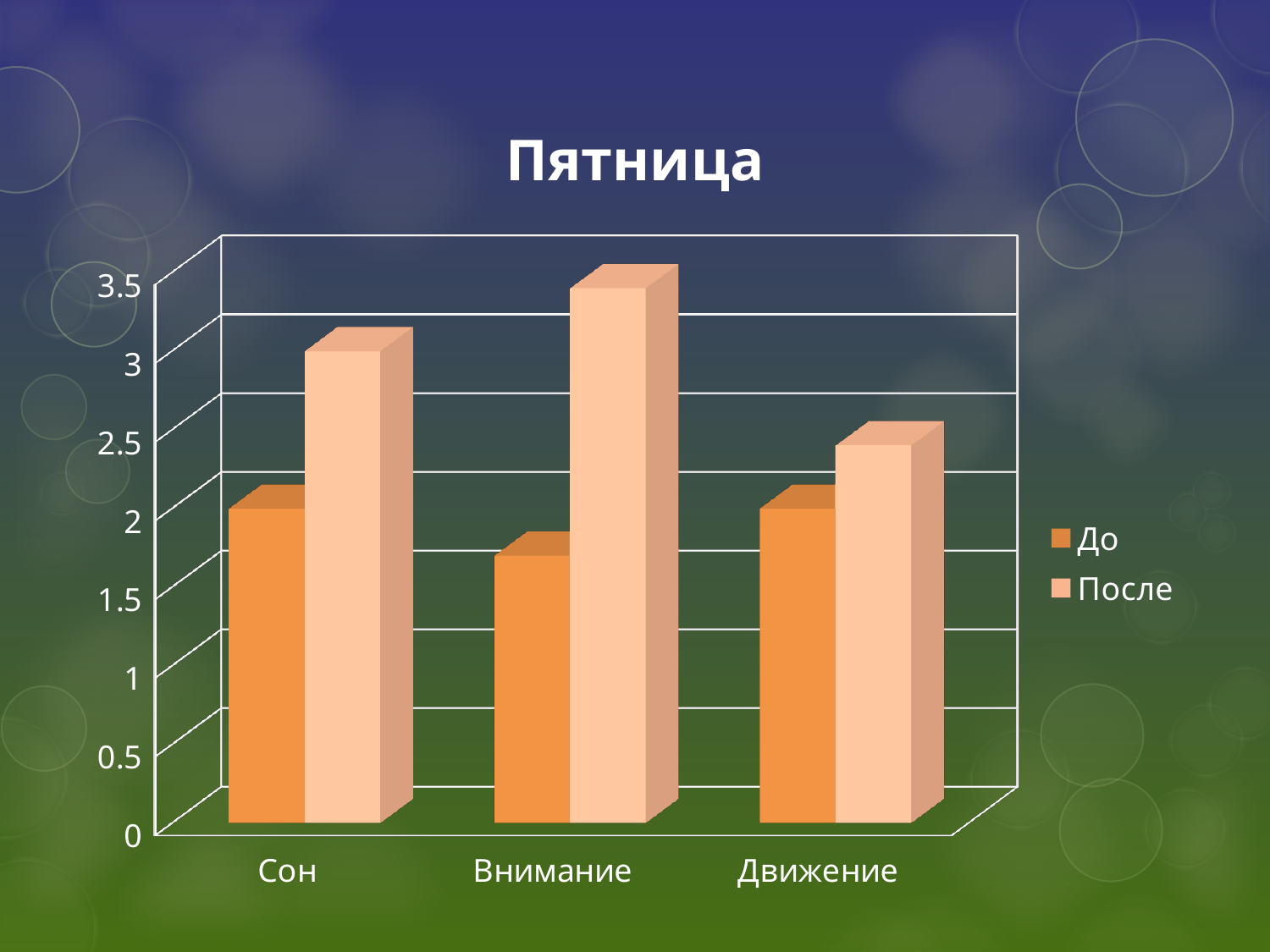
How many series does the legend list? 2 Which category has the highest value for the После series? Внимание Is the После value for Внимание greater or less than 3? greater For Внимание, which series has the larger value, До or После? После Is the До value for Внимание greater or less than 2? less What kind of chart is shown on the slide? bar chart How many categories are shown on the x axis? 3 Which category has the lowest value for the До series? Внимание What is the title of the chart? Пятница Which is larger: the После value for Сон or the После value for Движение? Сон Is the После value for Сон greater or less than 2.5? greater